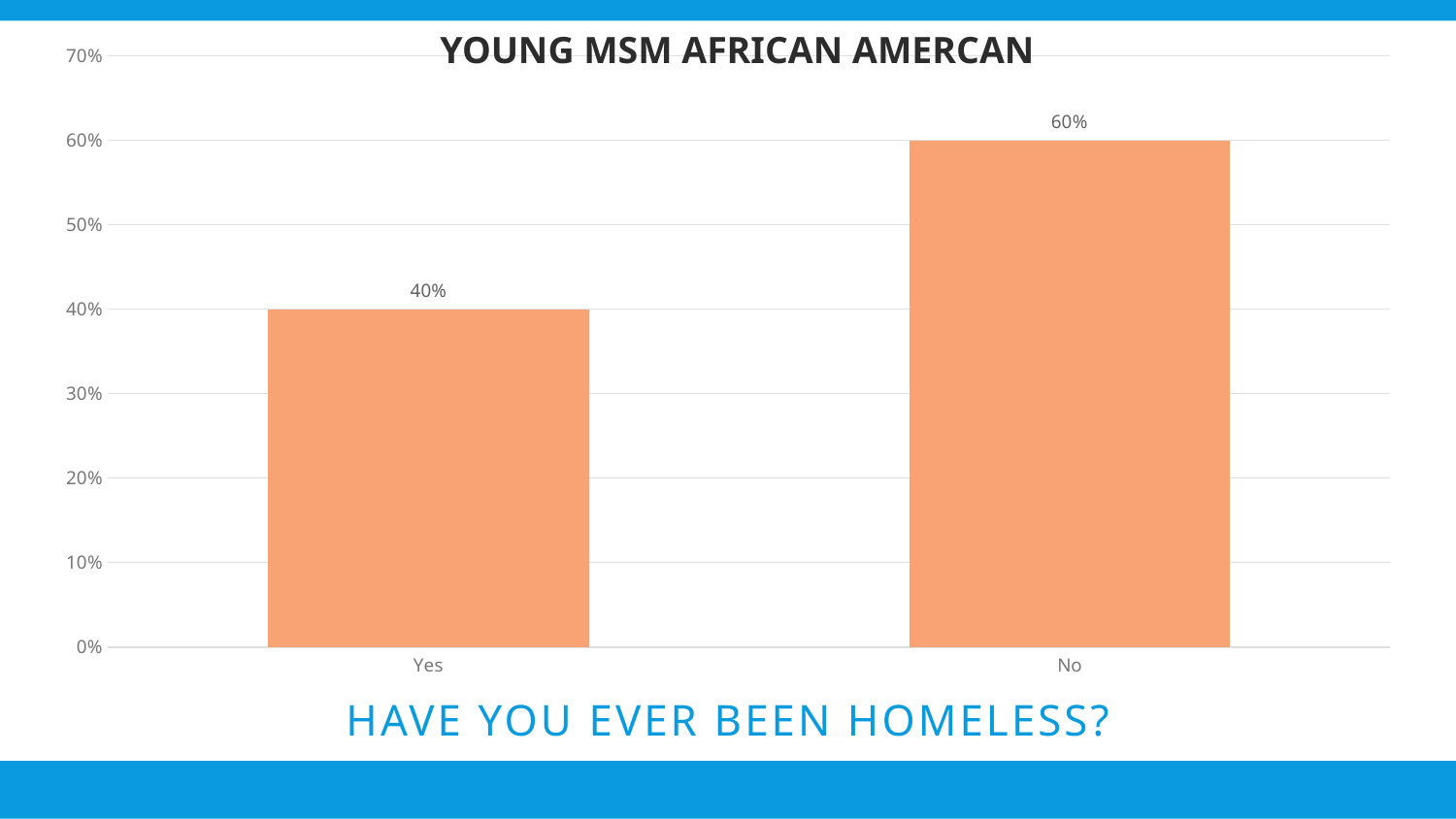
Is the value for Yes greater or less than 50%? less What kind of chart is shown on the slide? bar chart Which category has the highest value? No What is the difference between the values for No and Yes? 20% How many categories are shown on the x axis? 2 Which is larger, the value for Yes or the value for No? No Which category has the lowest value? Yes What is the value for No? 60% What is the title of the chart? YOUNG MSM AFRICAN AMERCAN What is the value for Yes? 40% Is the value for No greater or less than 50%? greater What is the highest value shown on the y axis? 70%